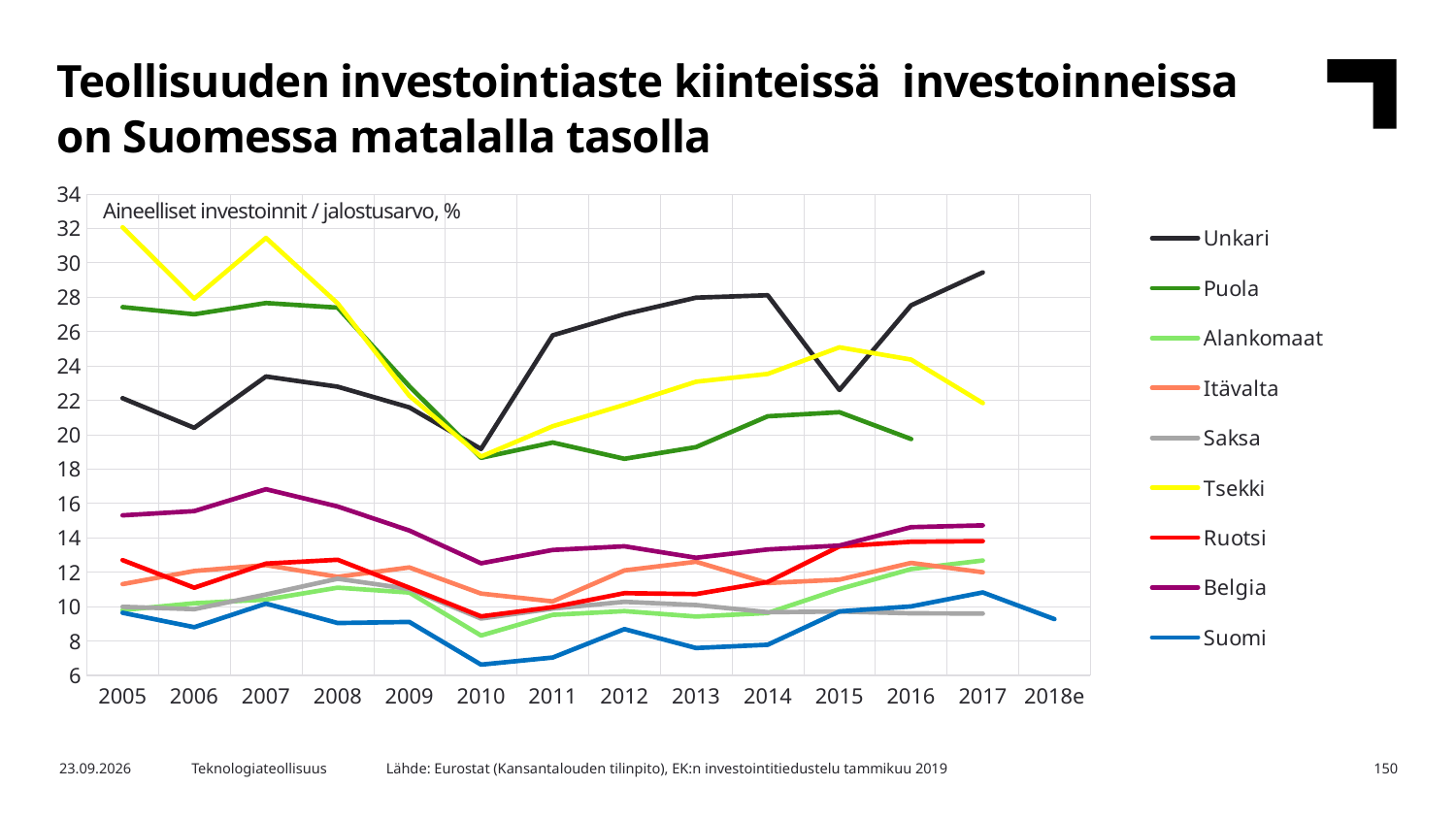
Which country has the highest value in 2005? Tsekki Which country has the lowest value in 2010? Suomi Is the value for Suomi in 2018e greater or less than 10? less How many series does the legend list? 9 Does the value for Unkari rise or fall from 2010 to 2014? rise Is the value for Tsekki in 2005 greater or less than 30? greater Is the value for Suomi in 2010 greater or less than 8? less What kind of chart is shown on the slide? line chart Which is higher in 2017, Unkari or Tsekki? Unkari How many years are shown on the x axis? 14 What label is printed inside the top left of the plot area? Aineelliset investoinnit / jalostusarvo, %